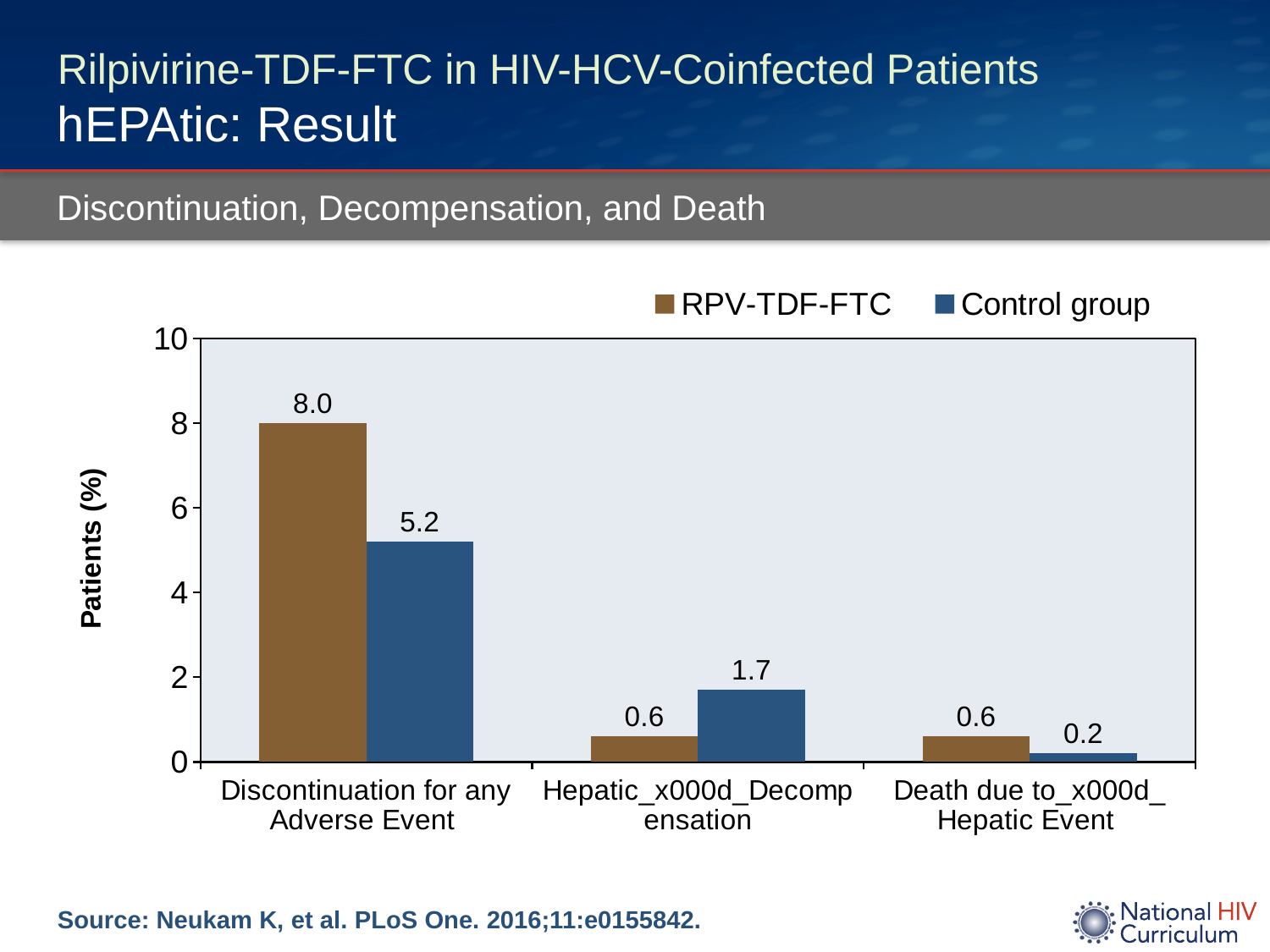
What is the value for RPV-TDF-FTC in the Death due to Hepatic Event category? 0.6 How many categories are shown on the x axis? 3 Which category has the highest value for RPV-TDF-FTC? Discontinuation for any Adverse Event What is the value for the Control group in the Hepatic Decompensation category? 1.7 In the Hepatic Decompensation category, which series has the larger value, RPV-TDF-FTC or Control group? Control group What is the value for RPV-TDF-FTC in the Discontinuation for any Adverse Event category? 8.0 What is the value for the Control group in the Discontinuation for any Adverse Event category? 5.2 What is the value for the Control group in the Death due to Hepatic Event category? 0.2 What kind of chart is shown on the slide? Bar chart How many series does the legend list? 2 What is the difference between the RPV-TDF-FTC and Control group values for Discontinuation for any Adverse Event? 2.8 Which category has the lowest value for the Control group? Death due to Hepatic Event